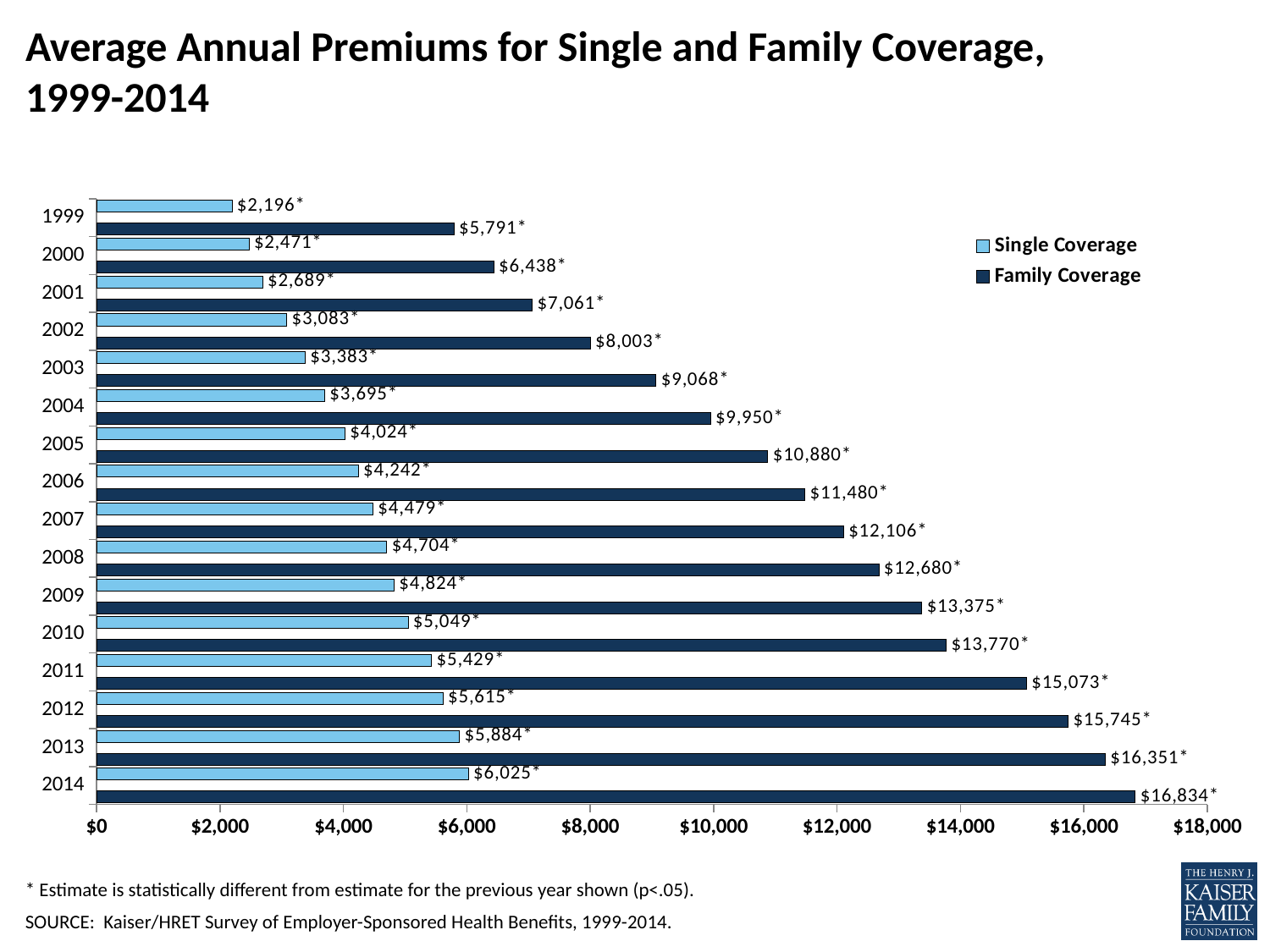
What is the difference between the Family Coverage premium and the Single Coverage premium in 2014? $10,809 What is the average annual premium for Family Coverage in 2005? $10,880 Which year has the lowest Single Coverage premium? 1999 What is the average annual premium for Single Coverage in 1999? $2,196 How many series does the legend list? 2 What is the average annual premium for Family Coverage in 2014? $16,834 Which year has the highest Family Coverage premium? 2014 Do the Single Coverage premiums rise or fall from 1999 to 2014? Rise How many years are shown on the chart? 16 What is the average annual premium for Single Coverage in 2008? $4,704 What kind of chart is shown on the slide? Bar chart Which is larger, the Family Coverage premium in 2010 or the Family Coverage premium in 2011? Family Coverage premium in 2011